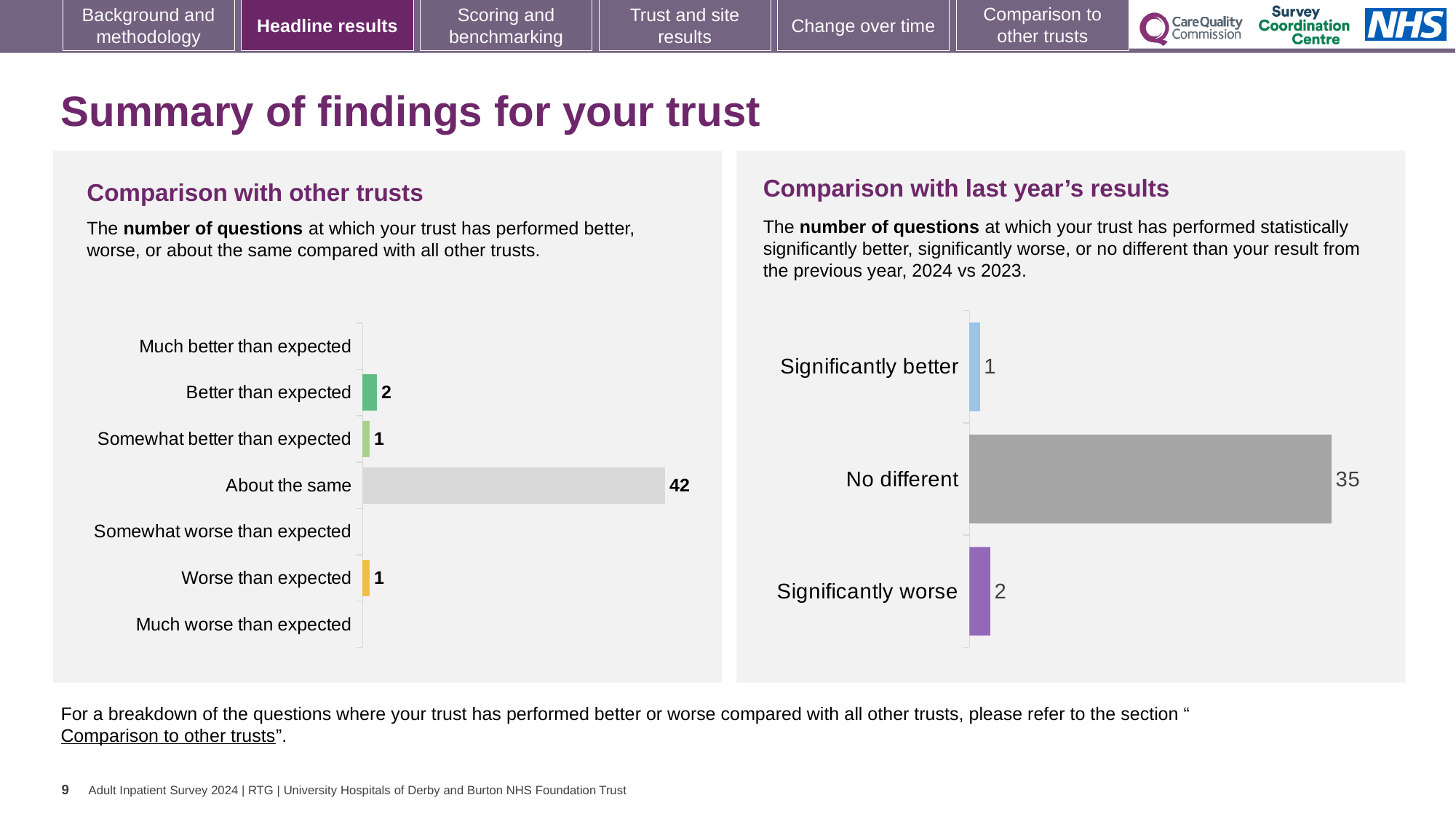
What type of chart is used in the 'Comparison with last year's results' panel? Bar chart In the 'Comparison with last year's results' chart, which category has the lowest number of questions? Significantly better In the 'Comparison with other trusts' chart, how many questions are 'Worse than expected'? 1 In the 'Comparison with other trusts' chart, what is the difference between 'About the same' and 'Better than expected'? 40 In the 'Comparison with last year's results' chart, how many questions are 'No different'? 35 In the 'Comparison with last year's results' chart, what is the total number of questions across all three categories? 38 In the 'Comparison with other trusts' chart, how many questions are 'About the same'? 42 In the 'Comparison with other trusts' chart, how many categories are listed on the axis? 7 In the 'Comparison with last year's results' chart, which is larger: 'Significantly better' or 'Significantly worse'? Significantly worse In the 'Comparison with other trusts' chart, how many questions are 'Better than expected'? 2 In the 'Comparison with other trusts' chart, which category has the highest number of questions? About the same In the 'Comparison with last year's results' chart, how many questions are 'Significantly worse'? 2